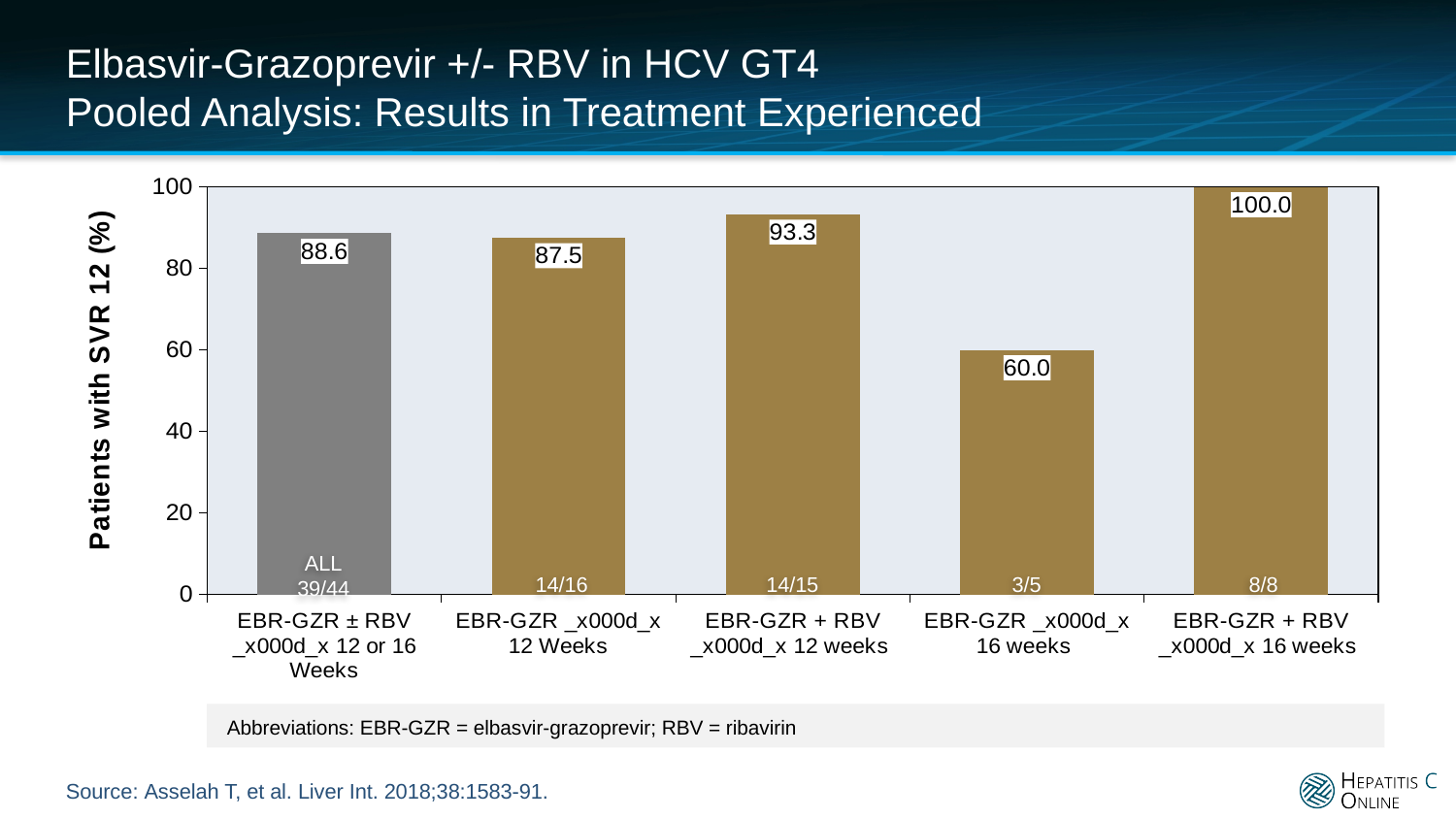
What fraction of patients is shown inside the bar for the EBR-GZR 12 Weeks group? 14/16 Is the SVR 12 rate for the EBR-GZR 16 weeks group greater or less than 80? less What is the label of the y-axis? Patients with SVR 12 (%) What is the difference in SVR 12 rate between the EBR-GZR + RBV 16 weeks group and the EBR-GZR 16 weeks group? 40.0 What is the SVR 12 rate for the EBR-GZR 16 weeks group? 60.0 What type of chart is shown on the slide? Bar chart What is the SVR 12 rate for the EBR-GZR ± RBV 12 or 16 Weeks (ALL) group? 88.6 Which treatment group has the lowest SVR 12 rate? EBR-GZR 16 weeks What is the SVR 12 rate for the EBR-GZR + RBV 12 weeks group? 93.3 Which treatment group has the highest SVR 12 rate? EBR-GZR + RBV 16 weeks Which has a higher SVR 12 rate: EBR-GZR 12 Weeks or EBR-GZR + RBV 12 weeks? EBR-GZR + RBV 12 weeks How many treatment groups (bars) are shown in the chart? 5